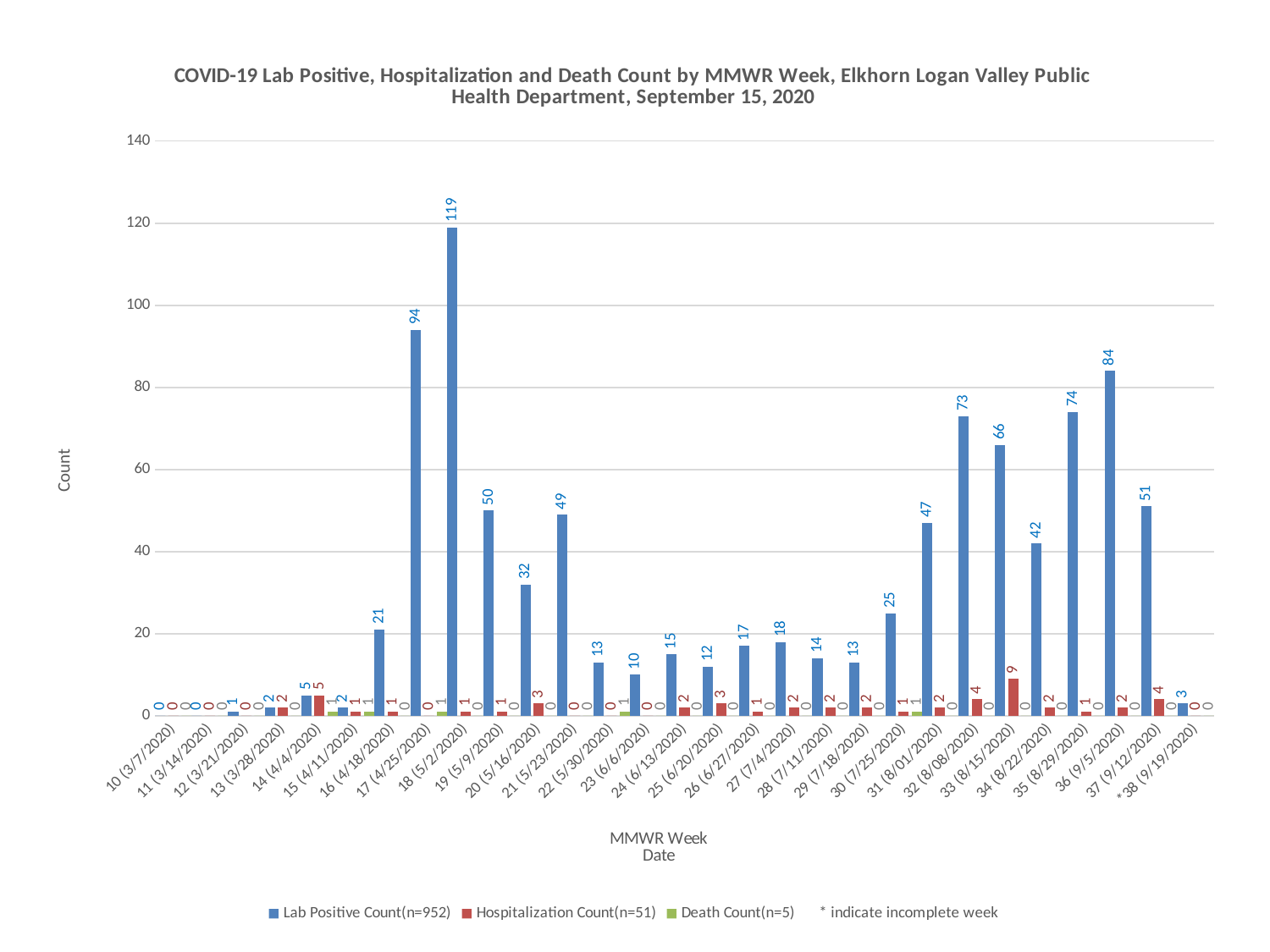
What is the difference between the Lab Positive Count in week 18 (5/2/2020) and week 17 (4/25/2020)? 25 How many MMWR weeks are shown on the x axis? 29 How many series does the legend list? 3 What is the Lab Positive Count for MMWR week 18 (5/2/2020)? 119 According to the legend, what does the asterisk (*) indicate? incomplete week Which MMWR week has the highest Hospitalization Count? 33 (8/15/2020) Is the Lab Positive Count for week 19 (5/9/2020) greater or less than 40? greater Which is larger, the Lab Positive Count for week 17 (4/25/2020) or for week 36 (9/5/2020)? week 17 (4/25/2020) What kind of chart is shown on the slide? bar chart What is the Hospitalization Count for MMWR week 37 (9/12/2020)? 4 What is the Lab Positive Count for MMWR week 36 (9/5/2020)? 84 Which MMWR week has the highest Lab Positive Count? 18 (5/2/2020)